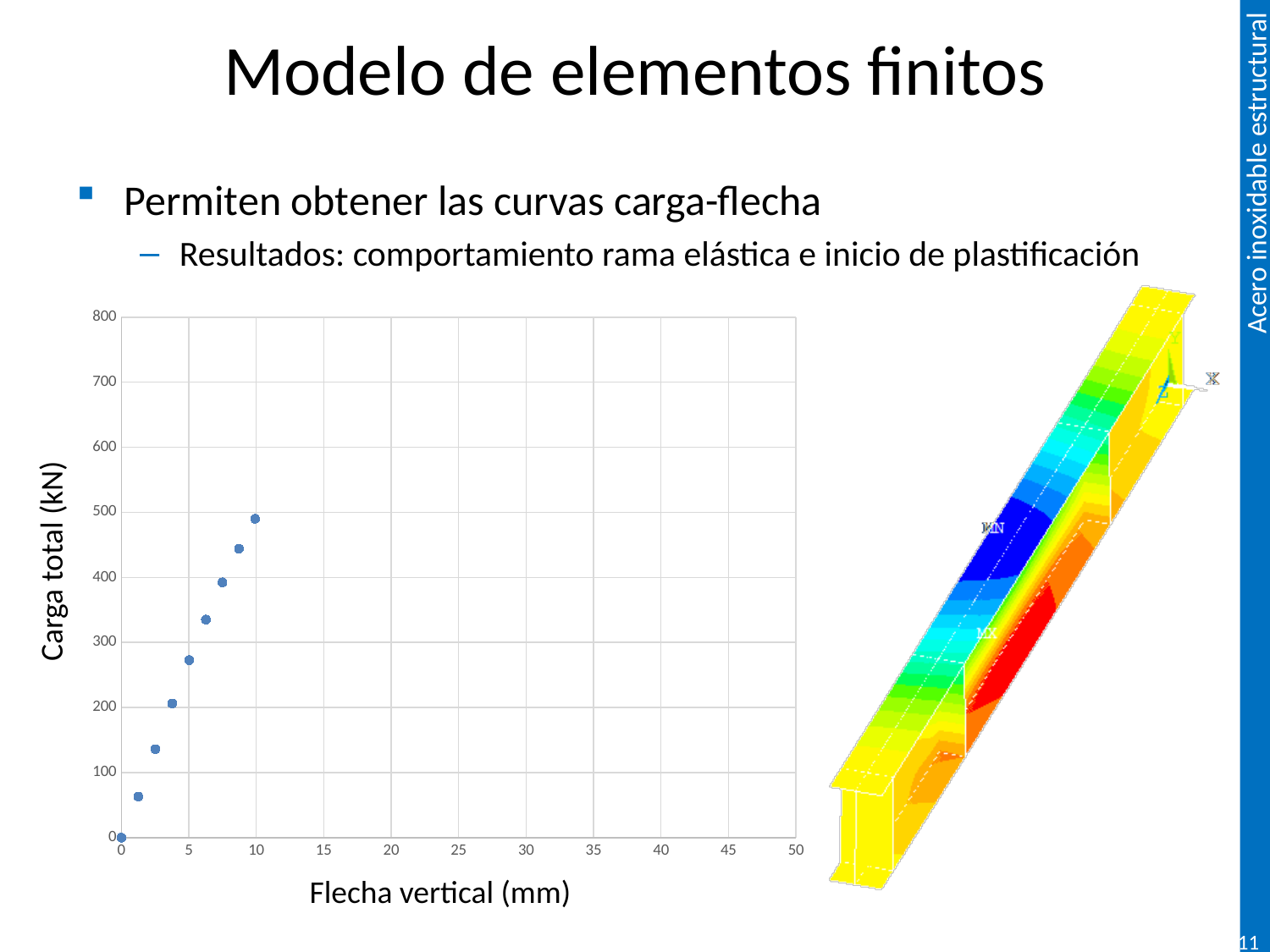
How many data points are plotted on the chart? 9 Is the Carga total of the point at about 5 mm of Flecha vertical greater or less than 200? greater Is the highest plotted value of Carga total greater or less than 500? less What is the label of the vertical axis of the chart? Carga total (kN) What is the maximum value shown on the vertical axis of the chart? 800 What kind of chart is shown on the slide? scatter chart Is the Carga total of the point at about 5 mm of Flecha vertical greater or less than 300? less What is the label of the horizontal axis of the chart? Flecha vertical (mm) Do the plotted values of Carga total rise or fall as Flecha vertical increases? rise